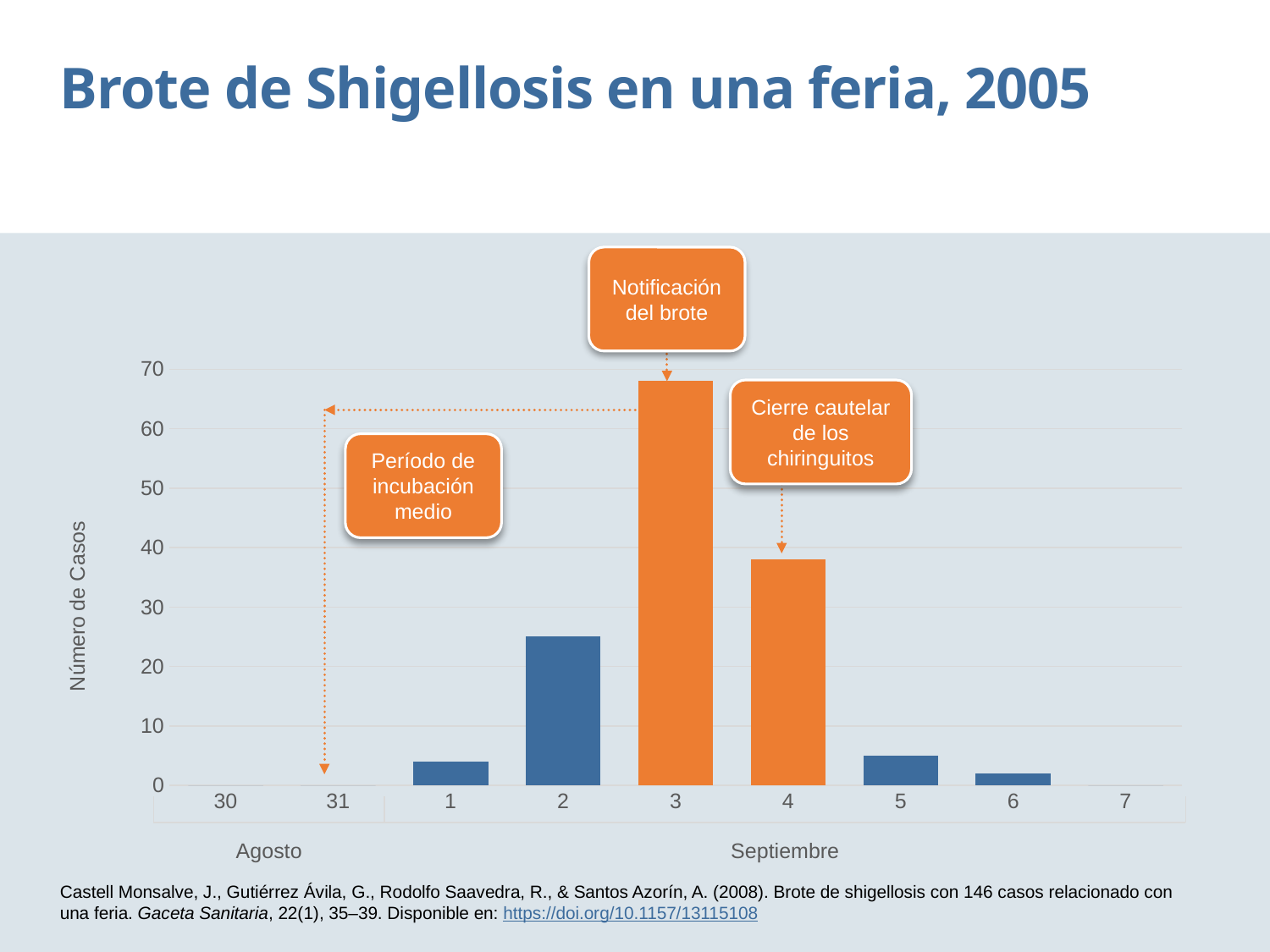
Which date has more cases, 2 September or 4 September? 4 Septiembre Is the number of cases on 2 September greater or less than 30? less What is the label of the y axis? Número de Casos Which date has the highest number of cases? 3 Septiembre How many dates are shown on the x axis? 9 Is the number of cases on 3 September greater or less than 60? greater Which date has more cases, 5 September or 6 September? 5 Septiembre Do the number of cases rise or fall from 3 September to 7 September? Fall Is the number of cases on 1 September greater or less than 10? less What kind of chart is shown on the slide? Bar chart Which event is annotated above the bar for 4 September? Cierre cautelar de los chiringuitos